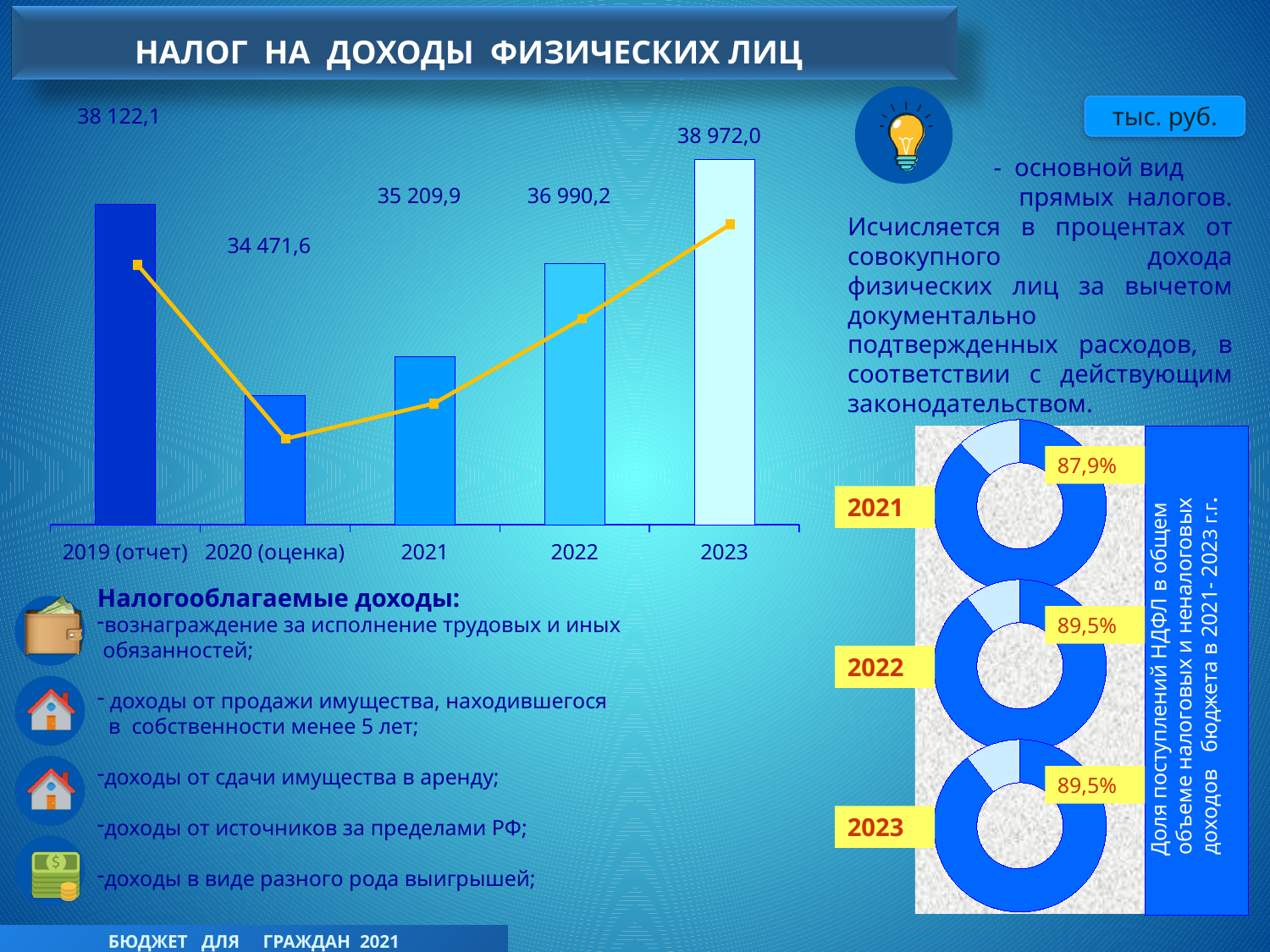
In the bar chart on the left, what is the difference between the values for 2022 and 2021? 1 780,3 In the donut charts on the right, what share is shown for 2021? 87,9% In the donut charts on the right, what share is shown for 2022? 89,5% In the bar chart on the left, do the values rise or fall from 2020 (оценка) to 2023? rise In the bar chart on the left, what is the value for 2020 (оценка)? 34 471,6 How many years are shown on the x axis of the bar chart on the left? 5 In the bar chart on the left, what is the difference between the values for 2023 and 2019 (отчет)? 849,9 In the bar chart on the left, which is larger: the value for 2021 or the value for 2022? 2022 In the bar chart on the left, which year has the lowest value? 2020 (оценка) In the bar chart on the left, which year has the highest value? 2023 In the bar chart on the left, what is the value for 2023? 38 972,0 In the bar chart on the left, what is the value for 2019 (отчет)? 38 122,1